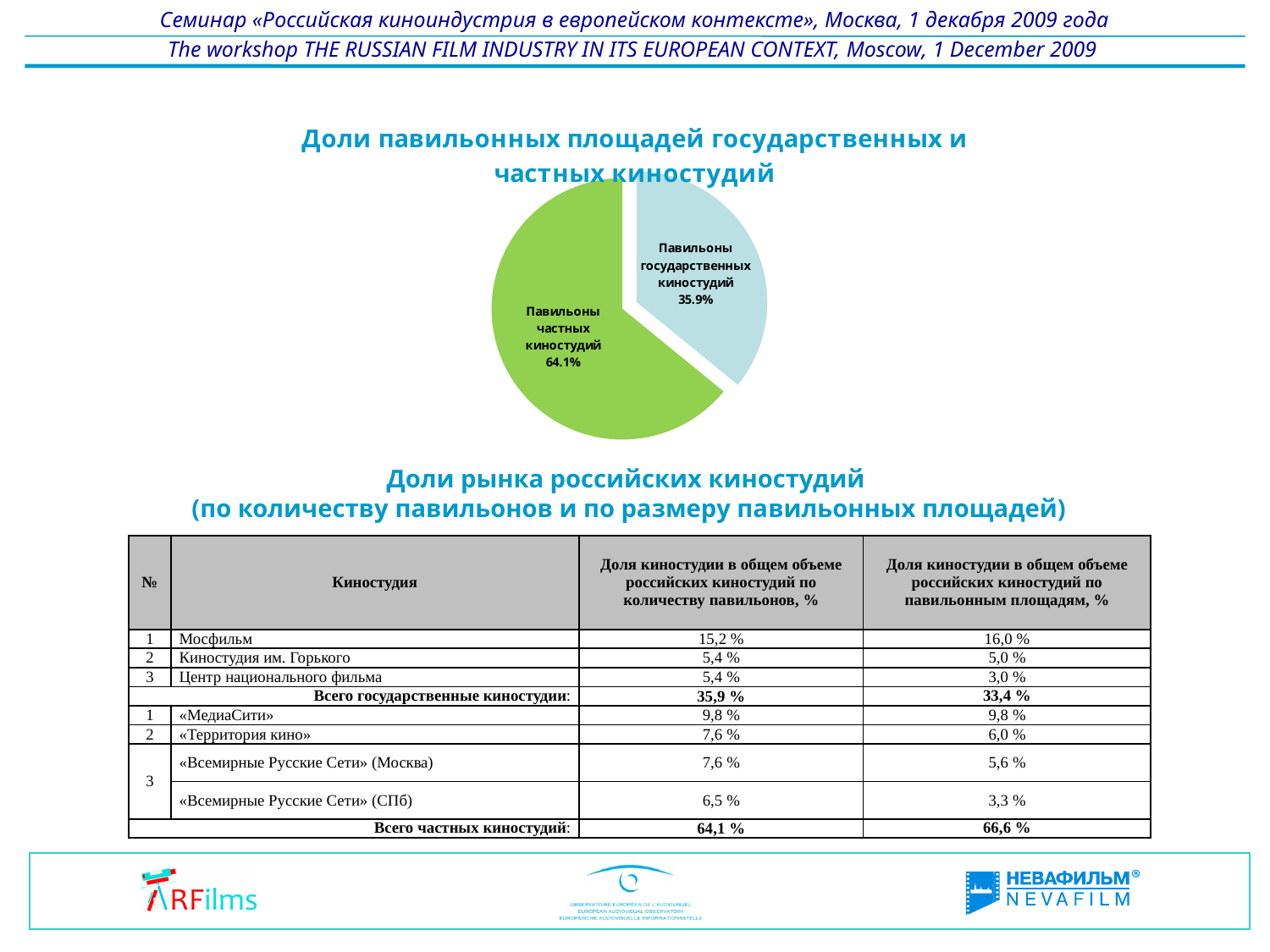
What is the difference in percentage points between the private studios slice (64.1%) and the state studios slice (35.9%)? 28.2 Is the share for «Павильоны государственных киностудий» greater or less than 50%? less What colour is the slice for «Павильоны частных киностудий»? Green What is the title of the pie chart? Доли павильонных площадей государственных и частных киностудий Which slice of the pie chart is the smallest? Павильоны государственных киностудий What is the share of the slice labelled «Павильоны частных киностудий»? 64.1% What is the share of the slice labelled «Павильоны государственных киностудий»? 35.9% Which is larger: the share for «Павильоны частных киностудий» or for «Павильоны государственных киностудий»? Павильоны частных киностудий What kind of chart is shown on the slide? Pie chart Which slice of the pie chart is the largest? Павильоны частных киностудий How many slices does the pie chart have? 2